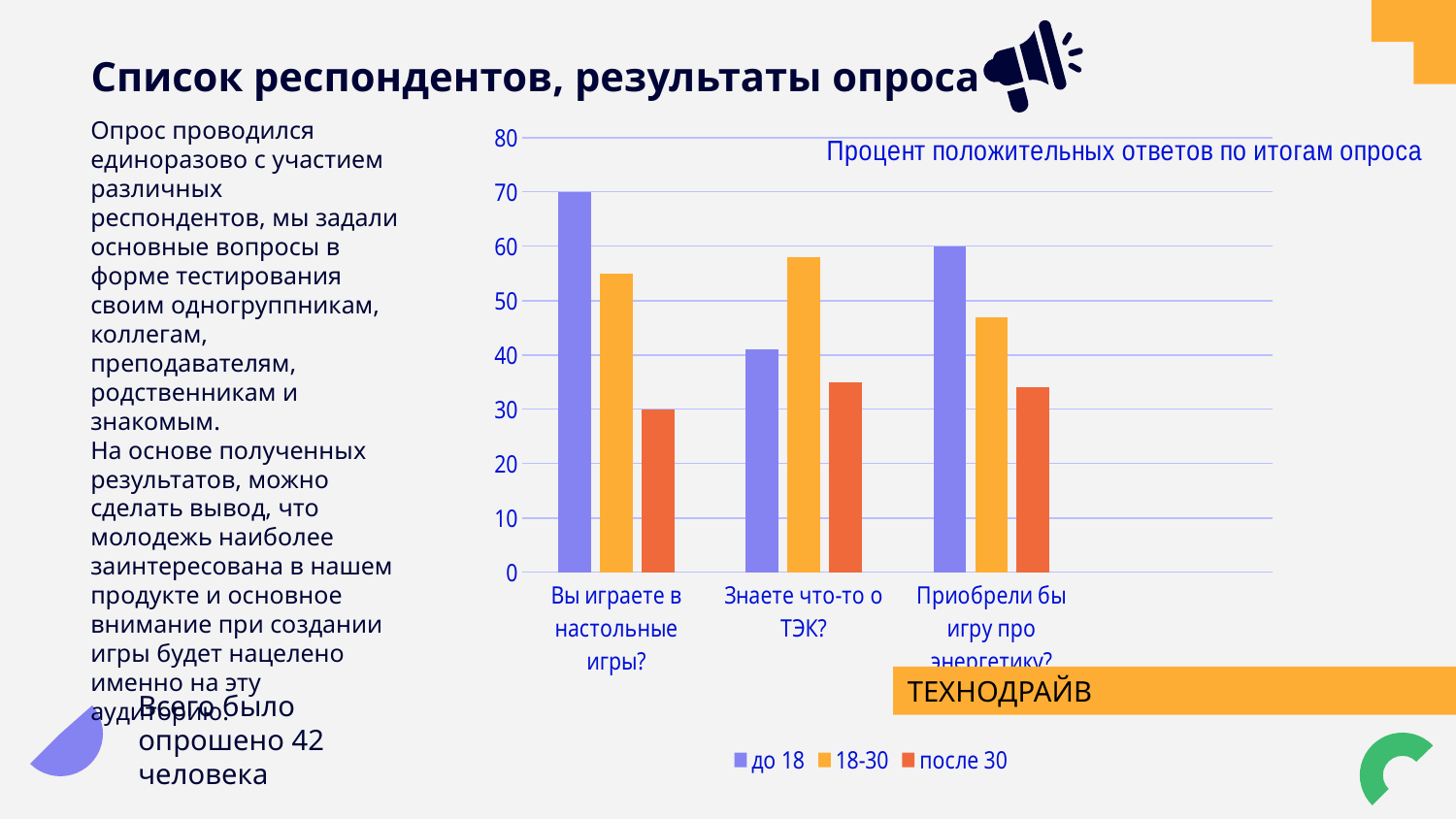
How many series does the chart legend list? 3 What is the title of the chart? Процент положительных ответов по итогам опроса What is the value for the 'после 30' series for 'Вы играете в настольные игры?'? 30 For 'Вы играете в настольные игры?', which is larger: the 'до 18' value or the '18-30' value? до 18 What kind of chart is shown on the slide? bar chart Is the value for the '18-30' series for 'Знаете что-то о ТЭК?' greater or less than 50? greater Is the value for the 'до 18' series for 'Знаете что-то о ТЭК?' greater or less than 50? less Which series has the highest value for 'Знаете что-то о ТЭК?'? 18-30 Which series has the lowest value for 'Приобрели бы игру про энергетику?'? после 30 What is the value for the 'до 18' series for 'Приобрели бы игру про энергетику?'? 60 How many question categories are shown on the x axis of the chart? 3 What is the value for the 'до 18' series for 'Вы играете в настольные игры?'? 70